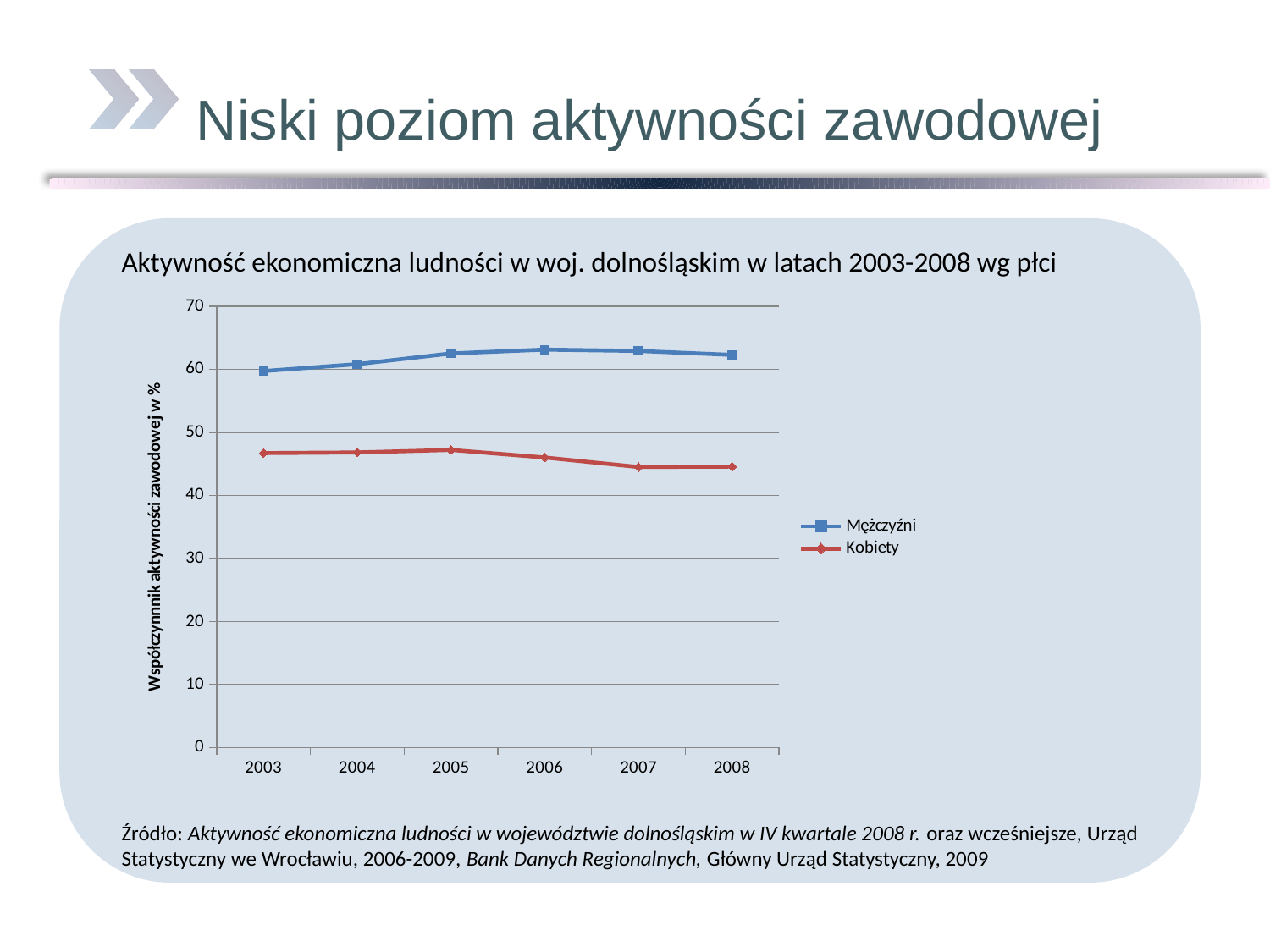
Which series has the higher value in 2006, Mężczyźni or Kobiety? Mężczyźni Is the value for Kobiety in 2005 greater or less than 50? less Do the values for Mężczyźni rise or fall from 2003 to 2006? rise What kind of chart is shown on the slide? Line chart How many years are plotted along the x axis? 6 In which year is the value for Mężczyźni lowest? 2003 Is the value for Mężczyźni in 2006 greater or less than 60? greater Do the values for Kobiety rise or fall from 2005 to 2007? fall Is the value for Kobiety in 2007 greater or less than 40? greater How many series does the legend list? 2 What is the title of the chart? Aktywność ekonomiczna ludności w woj. dolnośląskim w latach 2003-2008 wg płci Which series is drawn in red? Kobiety